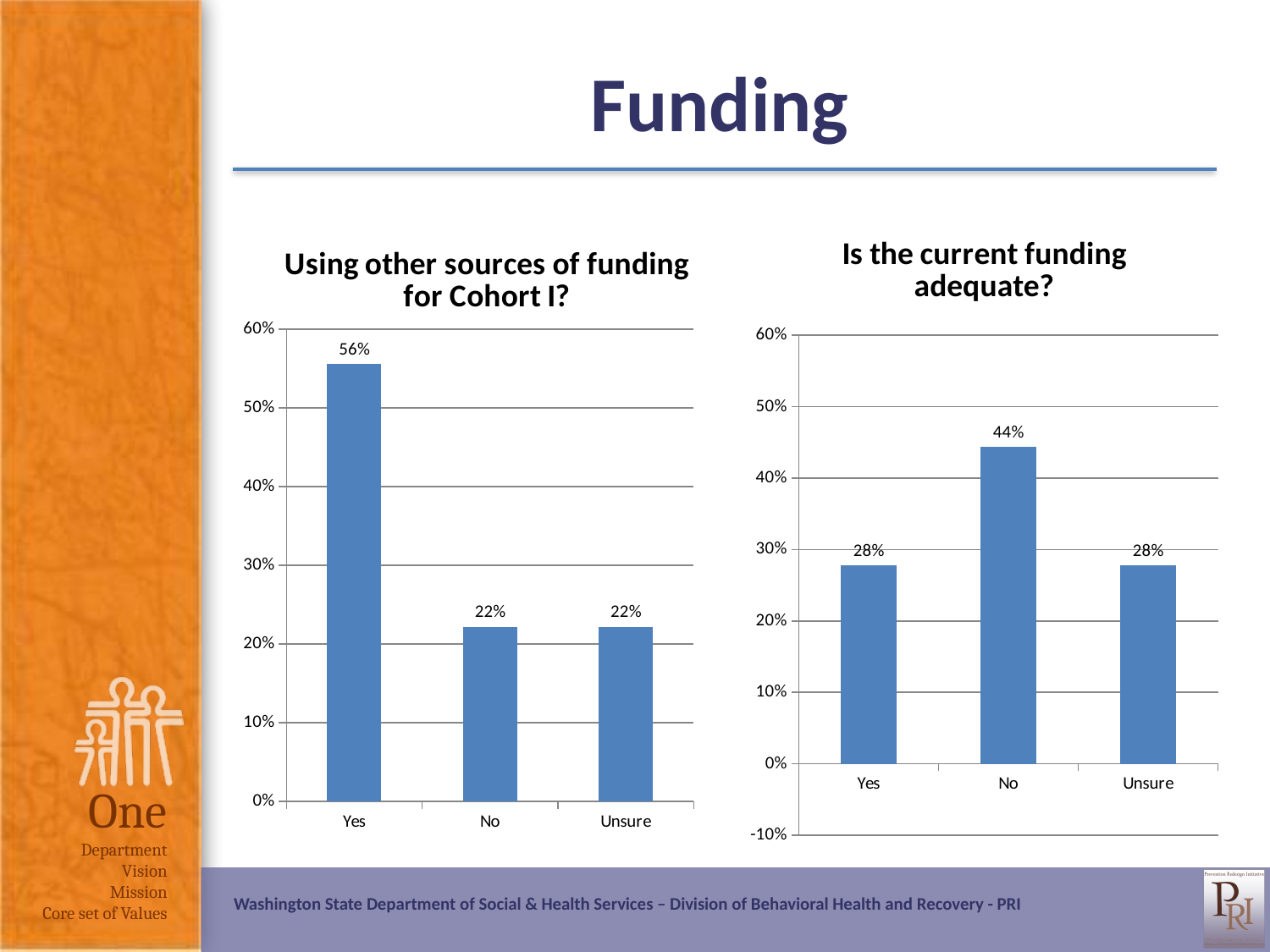
How many categories are shown in the chart 'Using other sources of funding for Cohort I?'? 3 In the chart 'Using other sources of funding for Cohort I?', what is the value for Yes? 56% In the chart 'Using other sources of funding for Cohort I?', which category has the highest value? Yes In the chart 'Is the current funding adequate?', which is larger, the value for Yes or the value for No? No In the chart 'Is the current funding adequate?', what is the difference between the values for No and Yes? 16% In the chart 'Is the current funding adequate?', what is the value for No? 44% What is the title of the chart on the left side of the slide? Using other sources of funding for Cohort I? What kind of chart is 'Is the current funding adequate?'? Bar chart In the chart 'Using other sources of funding for Cohort I?', what is the value for No? 22% In the chart 'Using other sources of funding for Cohort I?', what is the difference between the values for Yes and No? 34% In the chart 'Is the current funding adequate?', what is the value for Unsure? 28% In the chart 'Is the current funding adequate?', which category has the highest value? No